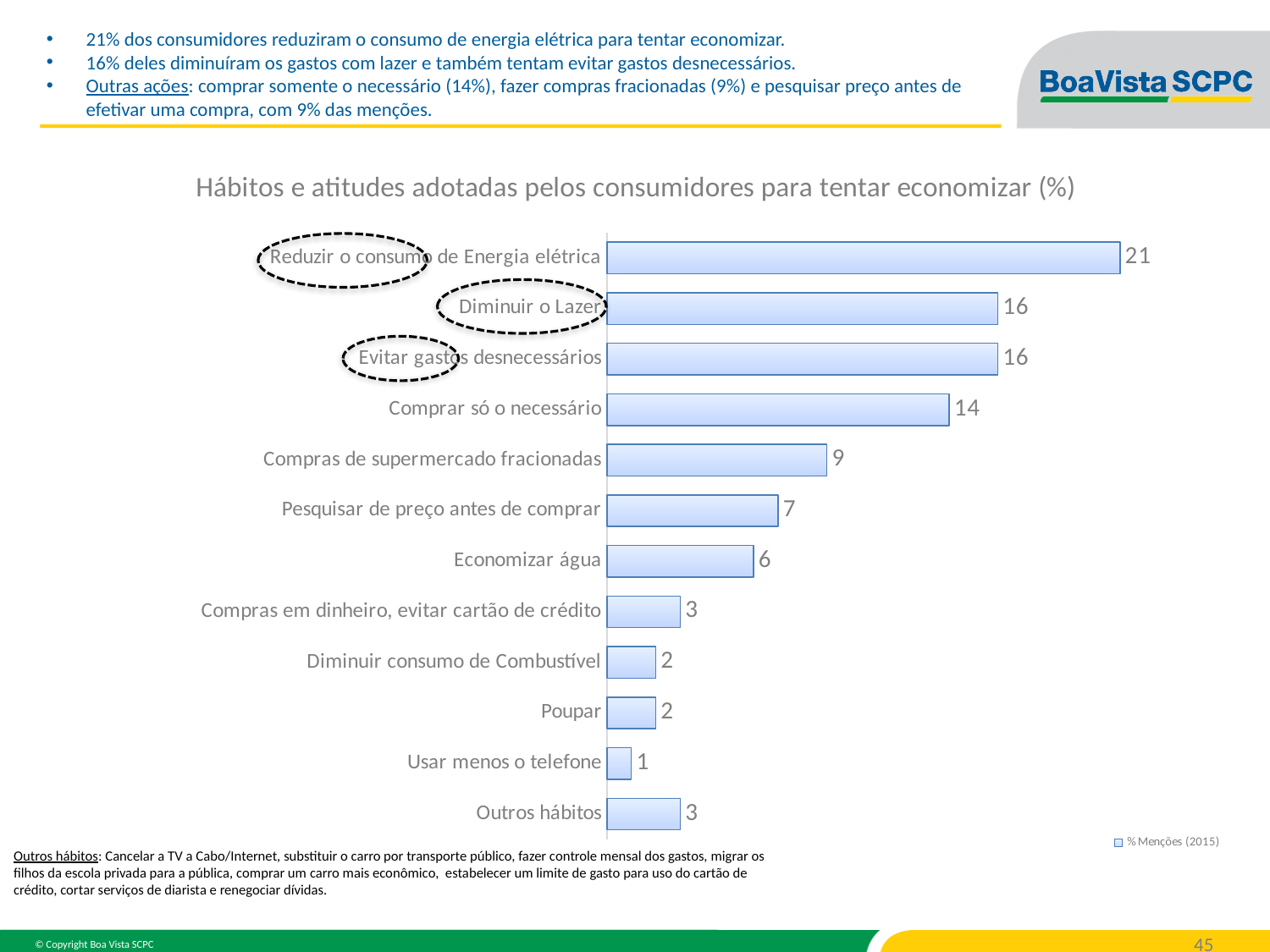
What is the value for "Reduzir o consumo de Energia elétrica"? 21 What is the difference between the values for "Reduzir o consumo de Energia elétrica" and "Diminuir o Lazer"? 5 Which category has the highest value? Reduzir o consumo de Energia elétrica What is the title of the chart? Hábitos e atitudes adotadas pelos consumidores para tentar economizar (%) What kind of chart is shown on the slide? Bar chart What is the value for "Outros hábitos"? 3 What is the value for "Economizar água"? 6 Which is larger, the value for "Compras de supermercado fracionadas" or the value for "Pesquisar de preço antes de comprar"? Compras de supermercado fracionadas What is the value for "Comprar só o necessário"? 14 How many categories are shown in the chart? 12 How many series does the legend list? 1 Which category has the lowest value? Usar menos o telefone